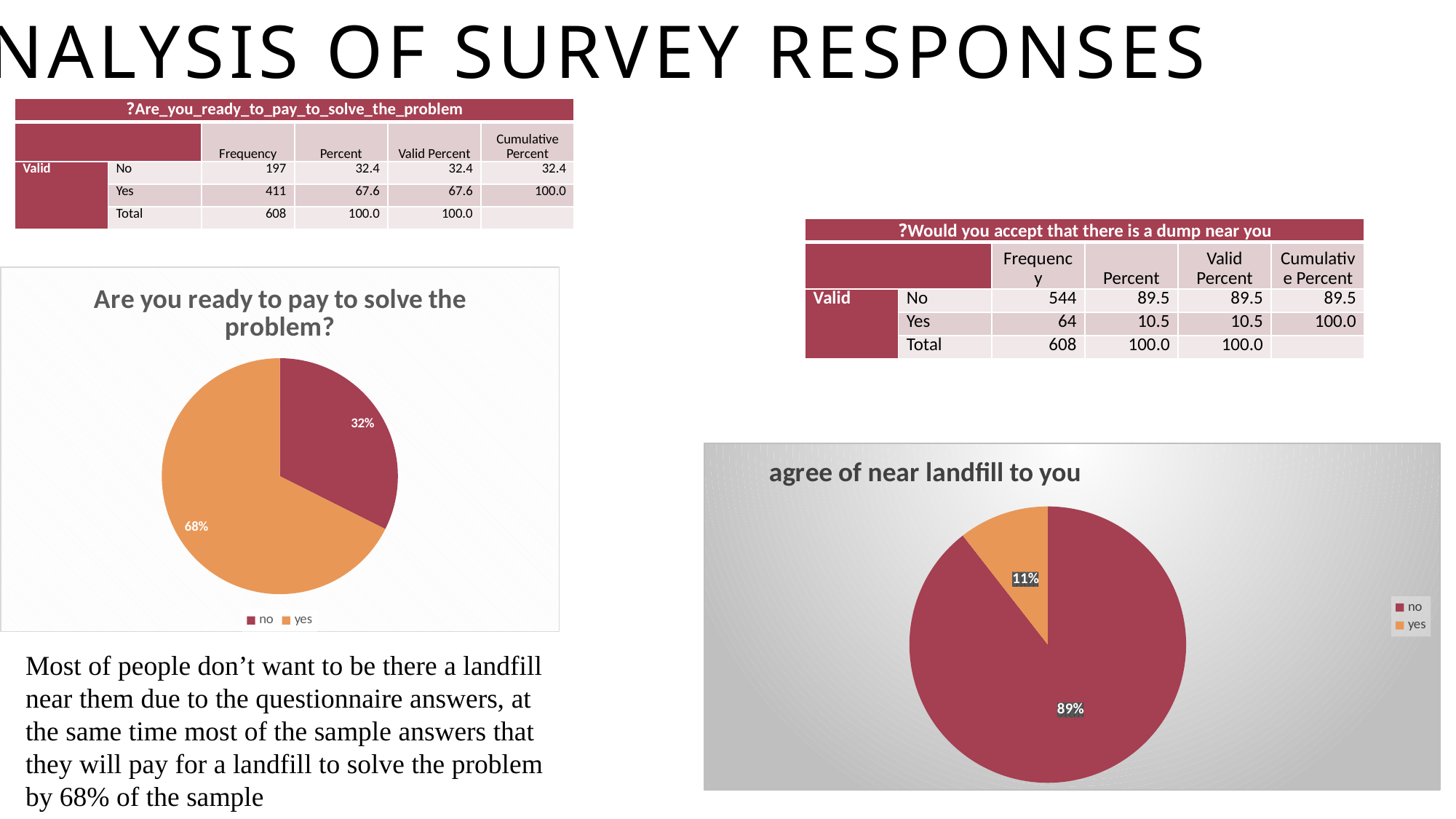
In the chart titled "Are you ready to pay to solve the problem?", what share of the pie is labelled "yes"? 68% In the chart titled "Are you ready to pay to solve the problem?", which slice is larger, "no" or "yes"? yes What kind of chart is the chart titled "agree of near landfill to you"? pie chart In the chart titled "Are you ready to pay to solve the problem?", what is the difference in percentage points between the "yes" and "no" slices? 36 In the chart titled "agree of near landfill to you", which slice is the smallest? yes In the chart titled "Are you ready to pay to solve the problem?", what share of the pie is labelled "no"? 32% How many slices does the chart titled "Are you ready to pay to solve the problem?" have? 2 In the chart titled "agree of near landfill to you", what share of the pie is labelled "no"? 89% In the chart titled "agree of near landfill to you", what colour is the "no" slice? dark red In the chart titled "agree of near landfill to you", what is the difference in percentage points between the "no" and "yes" slices? 78 In the chart titled "agree of near landfill to you", what share of the pie is labelled "yes"? 11% In the chart titled "Are you ready to pay to solve the problem?", which slice is the largest? yes